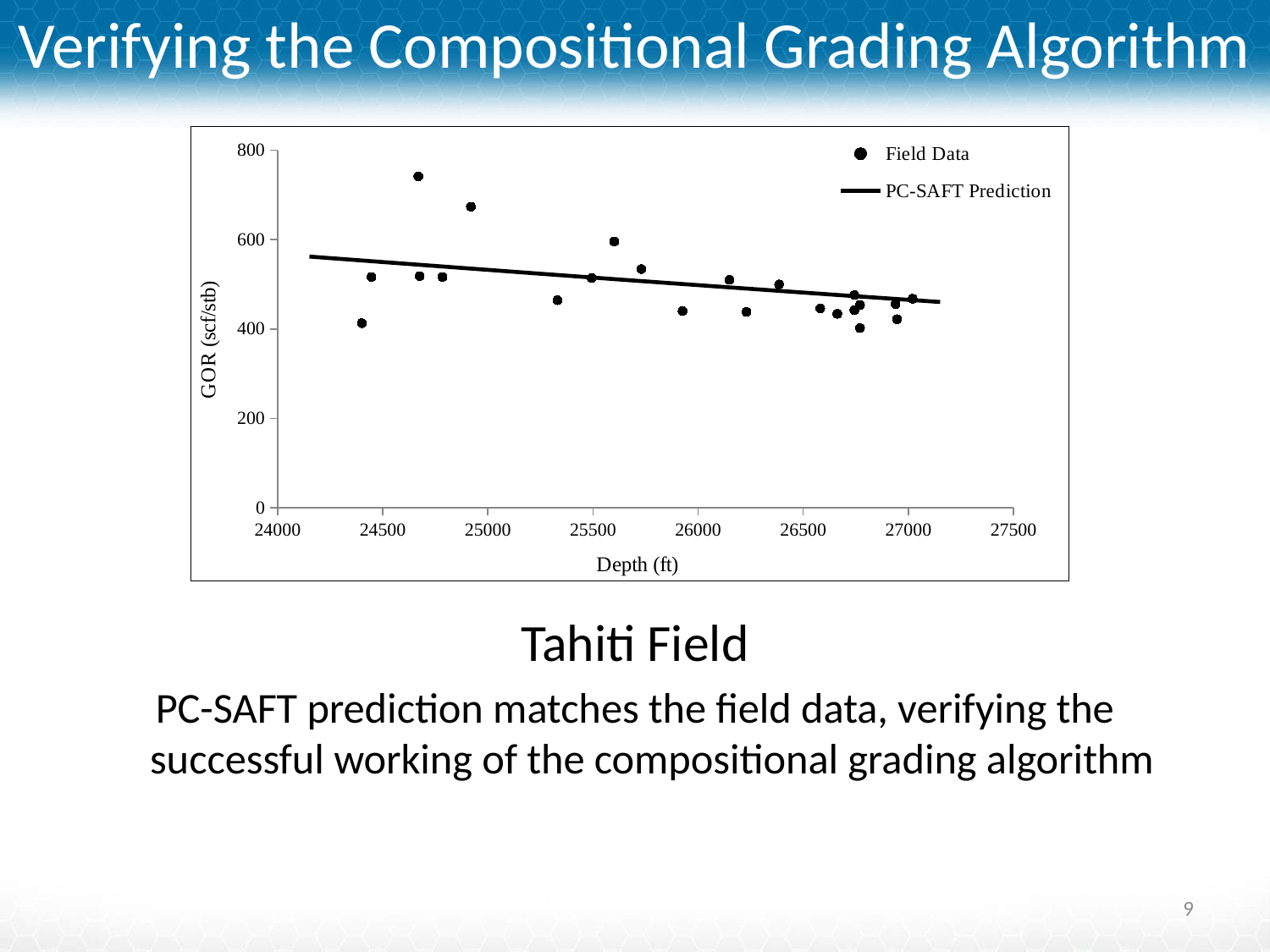
What is the maximum value shown on the GOR axis of the chart? 800 Is the value of the PC-SAFT Prediction line at 27000 ft greater or less than 500 scf/stb? less Is the value of the PC-SAFT Prediction line at its left end (near 24000 ft) greater or less than 600 scf/stb? less How many series does the chart legend list? 2 What is the label of the vertical axis of the chart? GOR (scf/stb) What kind of chart is shown on the slide? scatter chart What are the two entries in the chart legend? Field Data and PC-SAFT Prediction Is the highest Field Data point on the chart greater or less than 700 scf/stb? greater Does the PC-SAFT Prediction line rise or fall as depth increases along the x axis? fall Which is larger: the Field Data point near 24670 ft or the Field Data point near 24400 ft? the point near 24670 ft